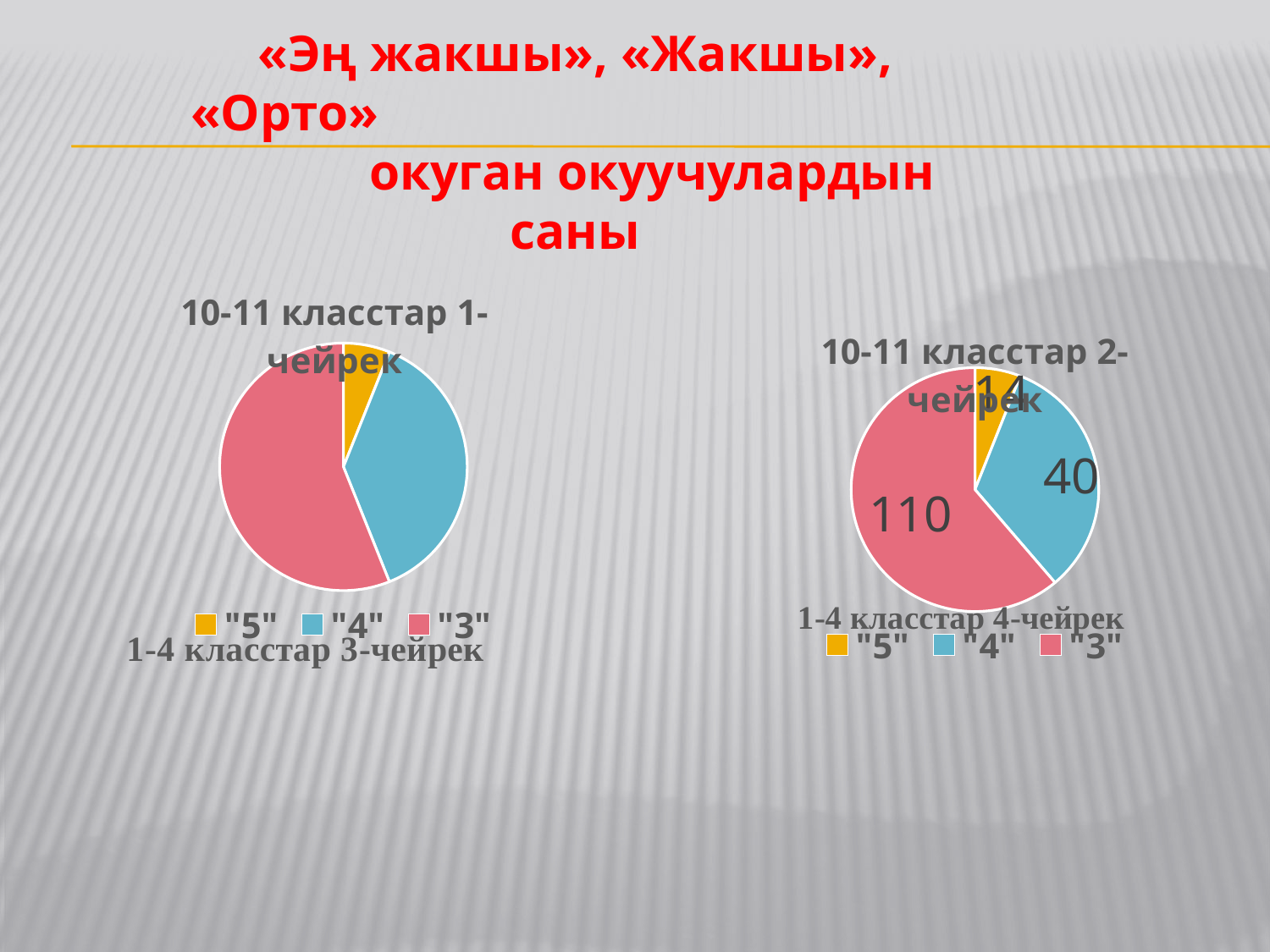
In the chart titled "10-11 класстар 2-чейрек", what is the value for "5"? 14 In the chart titled "10-11 класстар 2-чейрек", what is the value for "3"? 110 In the chart titled "10-11 класстар 2-чейрек", which category has the largest slice? "3" In the chart titled "10-11 класстар 1-чейрек", which category has the smallest slice? "5" In the chart titled "10-11 класстар 2-чейрек", what is the difference between the values for "3" and "4"? 70 In the chart titled "10-11 класстар 1-чейрек", which category has the largest slice? "3" What kind of chart is the chart titled "10-11 класстар 1-чейрек"? Pie chart In the chart titled "10-11 класстар 2-чейрек", which category has the smallest slice? "5" How many entries does the legend of the chart titled "10-11 класстар 2-чейрек" list? 3 In the chart titled "10-11 класстар 1-чейрек", which slice is larger, "4" or "3"? "3" In the chart titled "10-11 класстар 2-чейрек", what is the value for "4"? 40 In the chart titled "10-11 класстар 2-чейрек", what is the difference between the values for "4" and "5"? 26